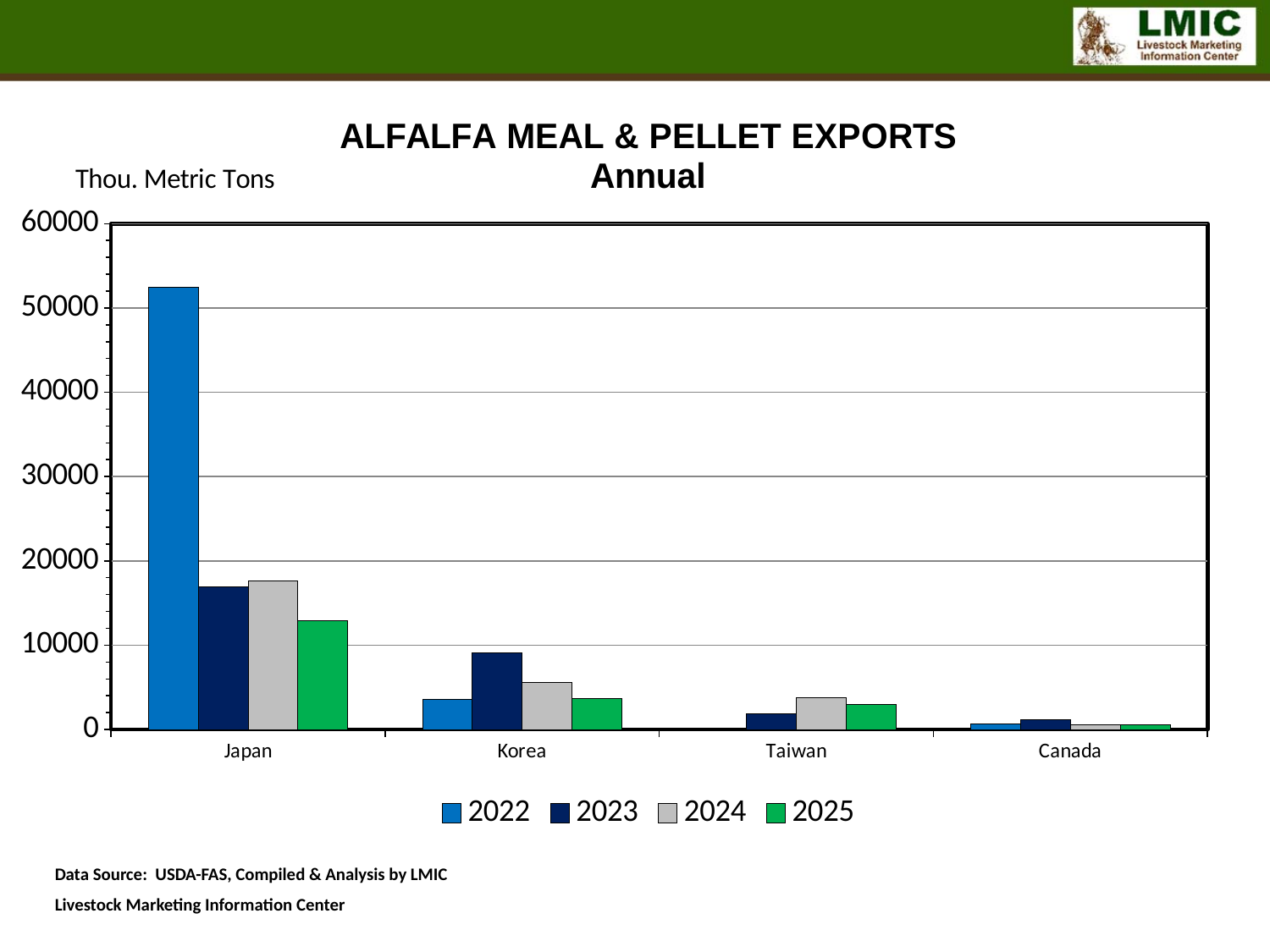
Is the 2023 value for Korea greater or less than 10000? less Which country has the highest 2022 value? Japan Is the 2022 value for Japan greater or less than 50000? greater How many countries are shown on the x axis of the chart? 4 Which country has the lowest 2025 value? Canada Is the 2023 value for Japan greater or less than 20000? less How many series does the legend list? 4 What unit is shown for the y axis of the chart? Thou. Metric Tons For Korea, which year has the larger value, 2022 or 2023? 2023 What kind of chart is shown on the slide? Bar chart For Japan, which year has the larger value, 2022 or 2023? 2022